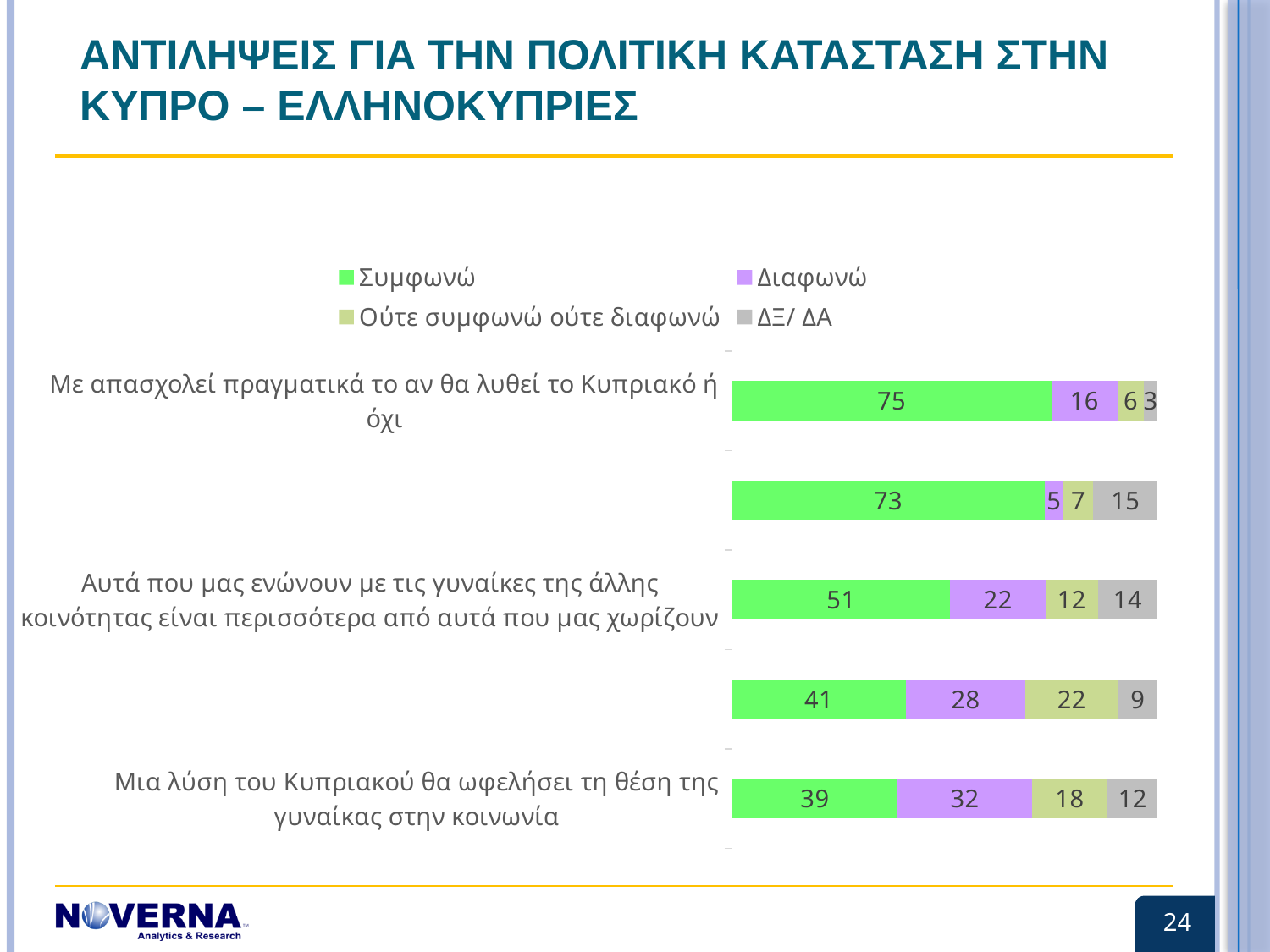
What is the value for ΔΞ/ΔΑ for the statement "Αυτά που μας ενώνουν με τις γυναίκες της άλλης κοινότητας είναι περισσότερα από αυτά που μας χωρίζουν"? 14 Which statement has the highest Συμφωνώ value? Με απασχολεί πραγματικά το αν θα λυθεί το Κυπριακό ή όχι What is the value for Συμφωνώ for the statement "Με απασχολεί πραγματικά το αν θα λυθεί το Κυπριακό ή όχι"? 75 What is the value for Διαφωνώ for the statement "Μια λύση του Κυπριακού θα ωφελήσει τη θέση της γυναίκας στην κοινωνία"? 32 Which statement has the lowest Συμφωνώ value? Μια λύση του Κυπριακού θα ωφελήσει τη θέση της γυναίκας στην κοινωνία What is the difference in the Συμφωνώ value between "Με απασχολεί πραγματικά το αν θα λυθεί το Κυπριακό ή όχι" and "Μια λύση του Κυπριακού θα ωφελήσει τη θέση της γυναίκας στην κοινωνία"? 36 What is the value for Ούτε συμφωνώ ούτε διαφωνώ for the statement "Μια λύση του Κυπριακού θα ωφελήσει τη θέση της γυναίκας στην κοινωνία"? 18 Which has the larger Διαφωνώ value: "Αυτά που μας ενώνουν με τις γυναίκες της άλλης κοινότητας είναι περισσότερα από αυτά που μας χωρίζουν" or "Μια λύση του Κυπριακού θα ωφελήσει τη θέση της γυναίκας στην κοινωνία"? Μια λύση του Κυπριακού θα ωφελήσει τη θέση της γυναίκας στην κοινωνία How many bars are plotted in the chart? 5 How many series does the legend list? 4 What is the total of the stacked bar for "Με απασχολεί πραγματικά το αν θα λυθεί το Κυπριακό ή όχι"? 100 What kind of chart is shown on the slide? Stacked bar chart